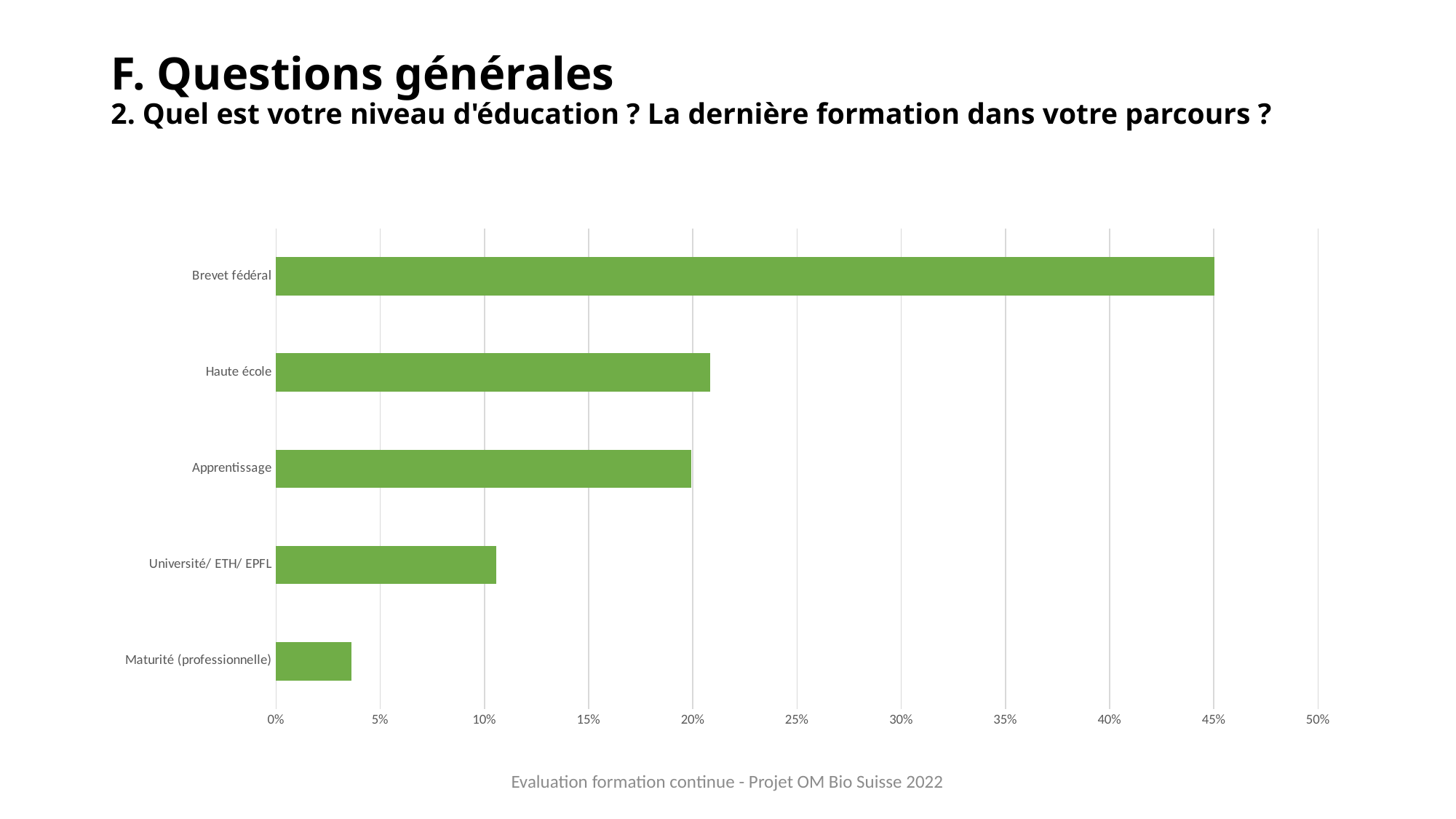
Which category has the highest value in the chart? Brevet fédéral Is the value for Maturité (professionnelle) greater or less than 5%? less Is the value for Apprentissage greater or less than 15%? greater Which is larger, the value for Brevet fédéral or the value for Haute école? Brevet fédéral Is the value for Haute école greater or less than 25%? less Which category has the lowest value in the chart? Maturité (professionnelle) How many education-level categories are plotted in the chart? 5 Which is larger, the value for Université/ ETH/ EPFL or the value for Maturité (professionnelle)? Université/ ETH/ EPFL What is the maximum value shown on the horizontal axis of the chart? 50% What kind of chart is shown on the slide? bar chart